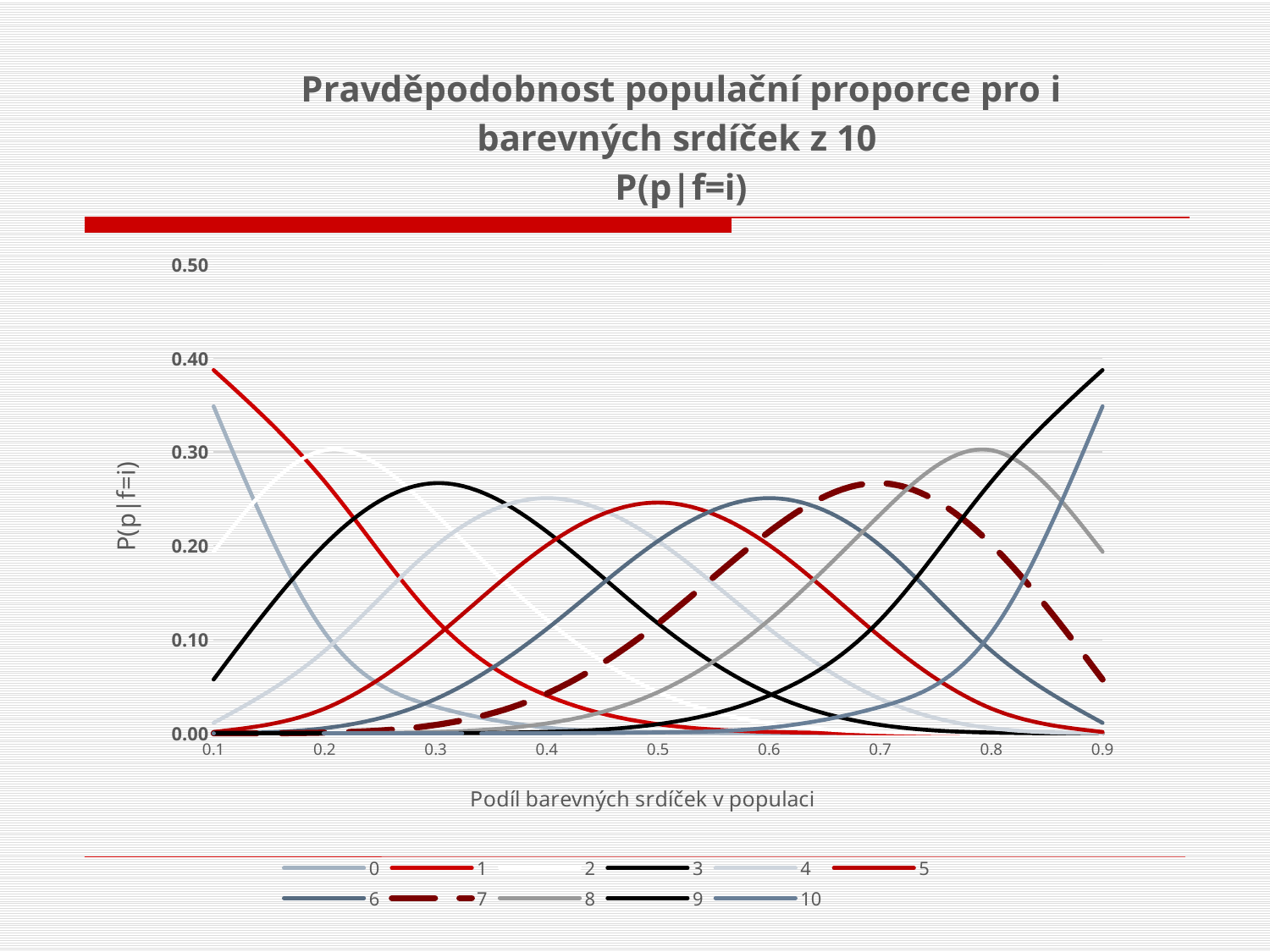
Is the value of series 1 at x = 0.1 greater or less than 0.30? greater Is the value of series 7 at x = 0.9 greater or less than 0.10? less What is the title of the y axis? P(p|f=i) How many series does the legend list? 11 How many tick values are labelled on the x axis? 9 Does series 9 rise or fall as x increases from 0.1 to 0.9? rise Is the value of series 9 at x = 0.9 greater or less than 0.30? greater At x = 0.5, which series has the larger value, series 5 or series 1? 5 Does series 1 rise or fall as x increases from 0.1 to 0.9? fall What is the title of the x axis? Podíl barevných srdíček v populaci What kind of chart is shown on the slide? line chart